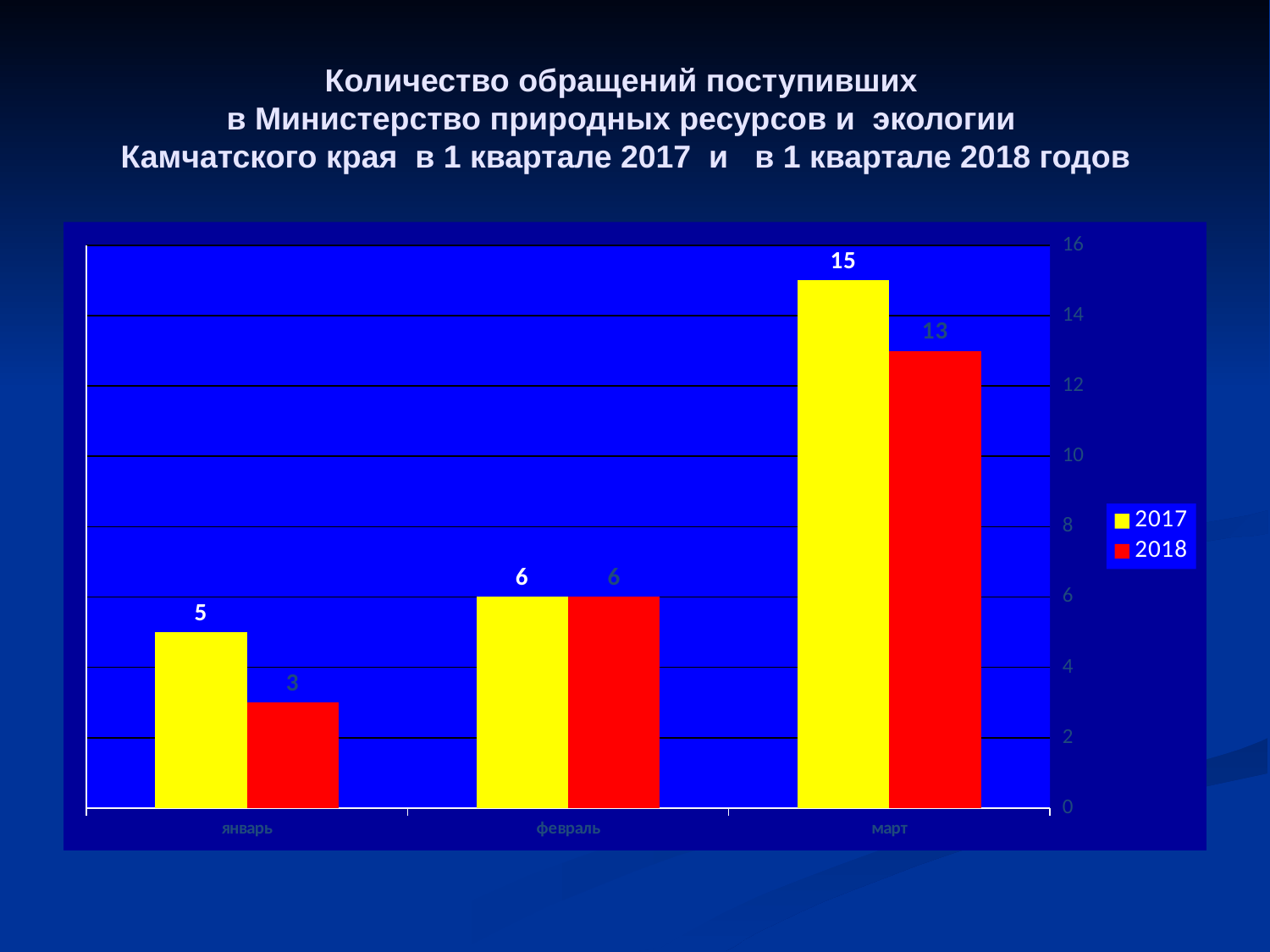
What is the value for 2017 in январь? 5 Which month has the highest value for the 2017 series? март What is the difference between the 2017 and 2018 values in март? 2 What kind of chart is shown on the slide? bar chart How many series does the legend list? 2 Which is larger in январь, the 2017 value or the 2018 value? 2017 Is the value for 2018 in март greater or less than 12? greater How many months are shown on the x axis? 3 Which month has the lowest value for the 2018 series? январь What is the value for 2018 in февраль? 6 What is the value for 2018 in март? 13 What is the difference between the 2017 and 2018 values in январь? 2